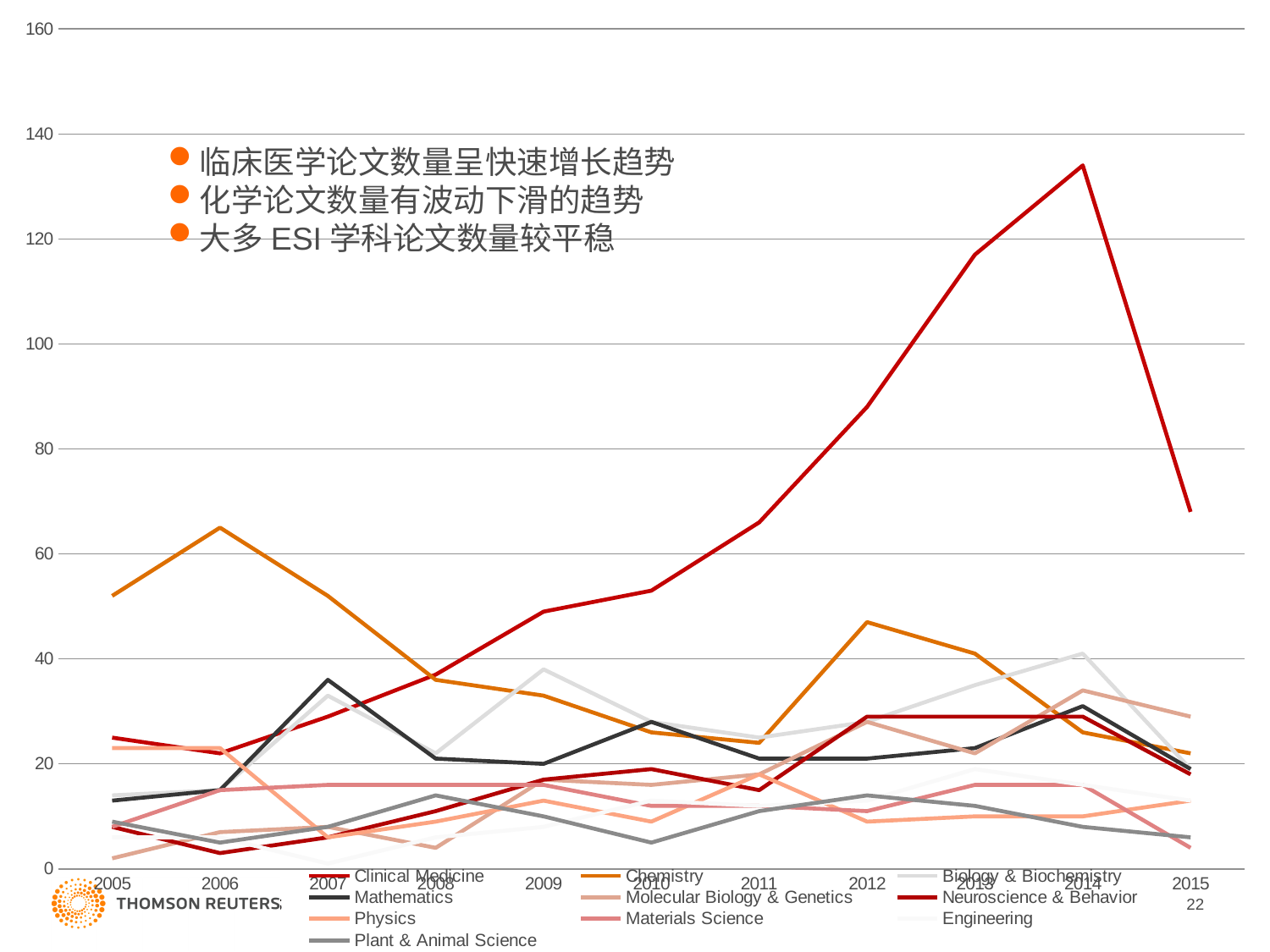
Is the value for Clinical Medicine in 2014 greater or less than 120? greater Is the value for Chemistry in 2006 greater or less than 60? greater Is the value for Clinical Medicine in 2015 greater or less than 60? greater Which is larger in 2013, Clinical Medicine or Chemistry? Clinical Medicine In which year does the Clinical Medicine line reach its highest value? 2014 What kind of chart is shown on the slide? line chart How many years are shown along the x axis? 11 What is the highest value shown on the y axis? 160 Which series reaches the highest value on the chart? Clinical Medicine Does the Clinical Medicine line rise or fall from 2008 to 2014? rise How many series does the legend list? 10